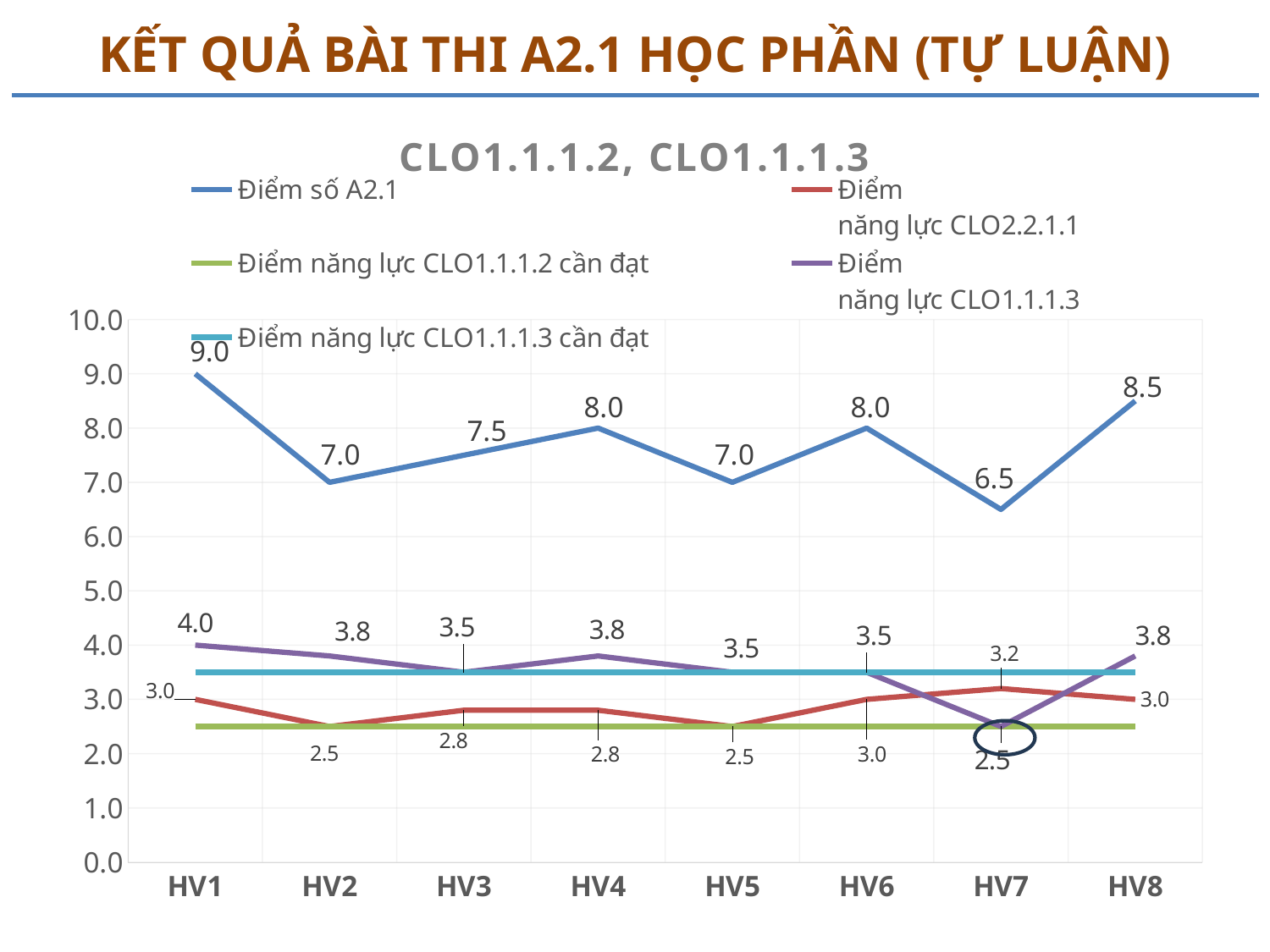
Which is larger, the Điểm số A2.1 value for HV4 or for HV8? HV8 Which student (HV) has the highest Điểm số A2.1? HV1 How many students (HV categories) are shown on the x axis? 8 What kind of chart is shown on the slide? Line chart What is the title of the chart? CLO1.1.1.2, CLO1.1.1.3 What is the Điểm năng lực CLO1.1.1.3 value for HV4? 3.8 What is the Điểm số A2.1 value for HV7? 6.5 What is the Điểm số A2.1 value for HV1? 9.0 Which student (HV) has the lowest Điểm số A2.1? HV7 What is the difference between the Điểm số A2.1 values for HV1 and HV7? 2.5 How many series does the legend list? 5 What is the Điểm năng lực CLO2.2.1.1 value for HV7? 3.2